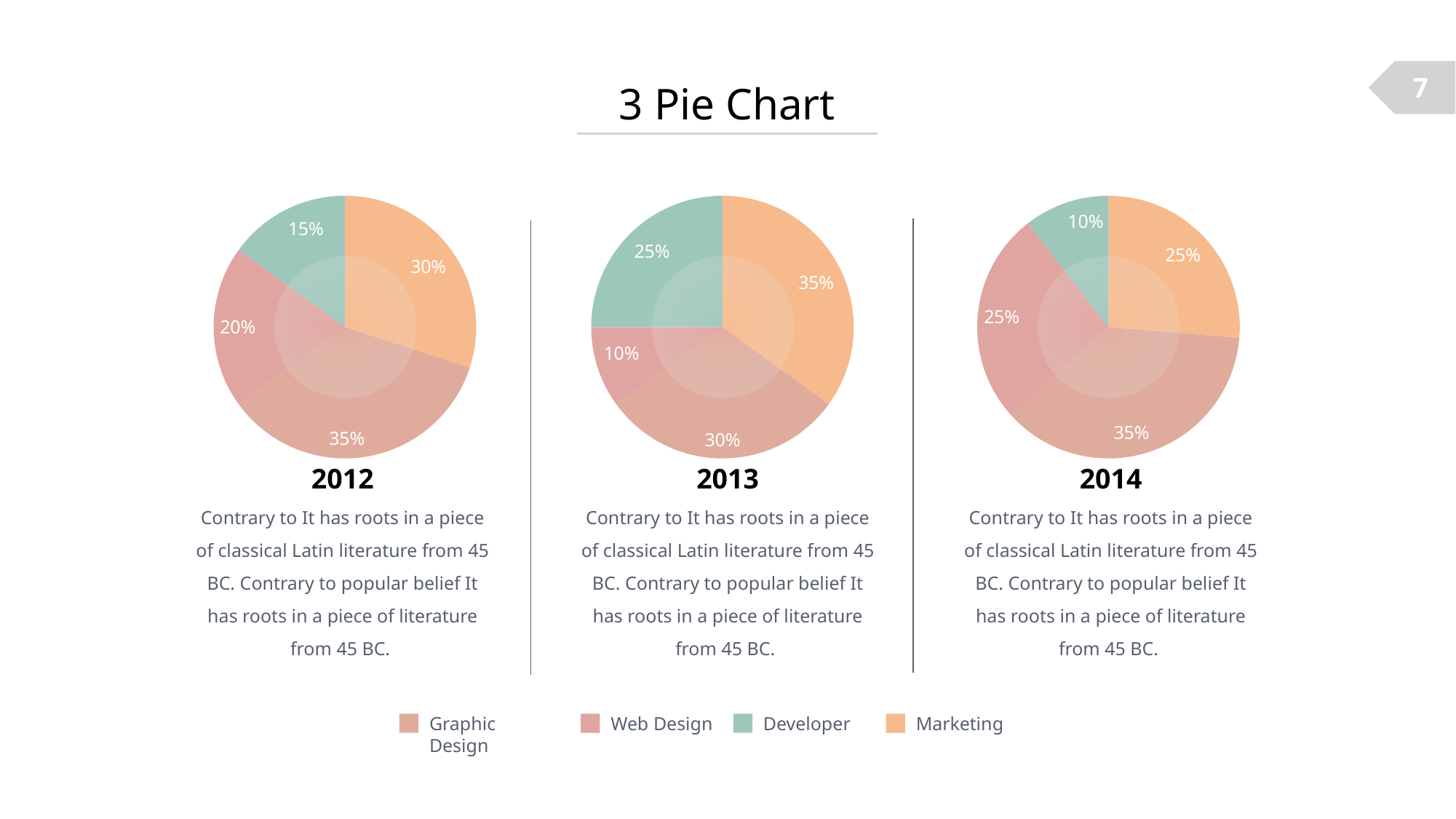
In the 2012 pie chart, what is the difference between the Graphic Design and Web Design shares? 15% In the 2012 pie chart, what share does Marketing have? 30% How many series does the legend list? 4 What type of chart is used for 2012, 2013 and 2014? Pie chart In the 2013 pie chart, what share does Web Design have? 10% In the 2012 pie chart, what share does Developer have? 15% In the 2013 pie chart, which is larger, Developer or Web Design? Developer In the 2014 pie chart, what share does Graphic Design have? 35% In the 2013 pie chart, which category has the largest slice? Marketing How many slices does the 2014 pie chart have? 4 In the 2014 pie chart, which category has the smallest slice? Developer What is the title of the slide? 3 Pie Chart